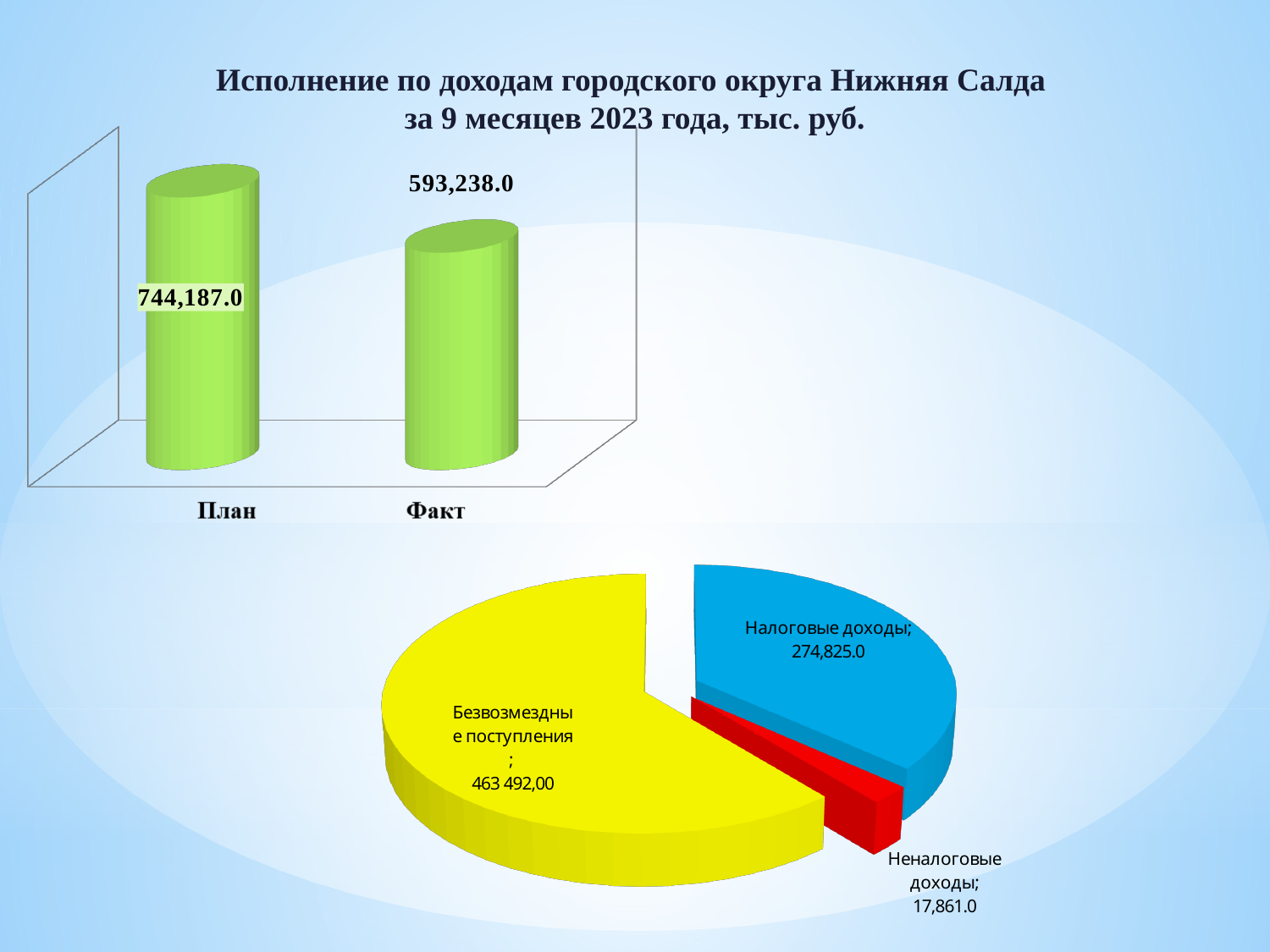
On the top bar chart, how many categories are shown? 2 On the bottom pie chart, what colour is the Налоговые доходы slice? Blue On the top bar chart, what is the value for План? 744,187.0 On the top bar chart, what is the difference between the План and Факт values? 150,949.0 On the top bar chart, which category has the higher value, План or Факт? План What type of chart is the top chart on the slide? Bar chart On the bottom pie chart, which slice is the largest? Безвозмездные поступления On the bottom pie chart, what is the value for Налоговые доходы? 274,825.0 What type of chart is the bottom chart on the slide? Pie chart On the top bar chart, what is the value for Факт? 593,238.0 On the bottom pie chart, which slice is the smallest? Неналоговые доходы On the bottom pie chart, what is the value for Неналоговые доходы? 17,861.0